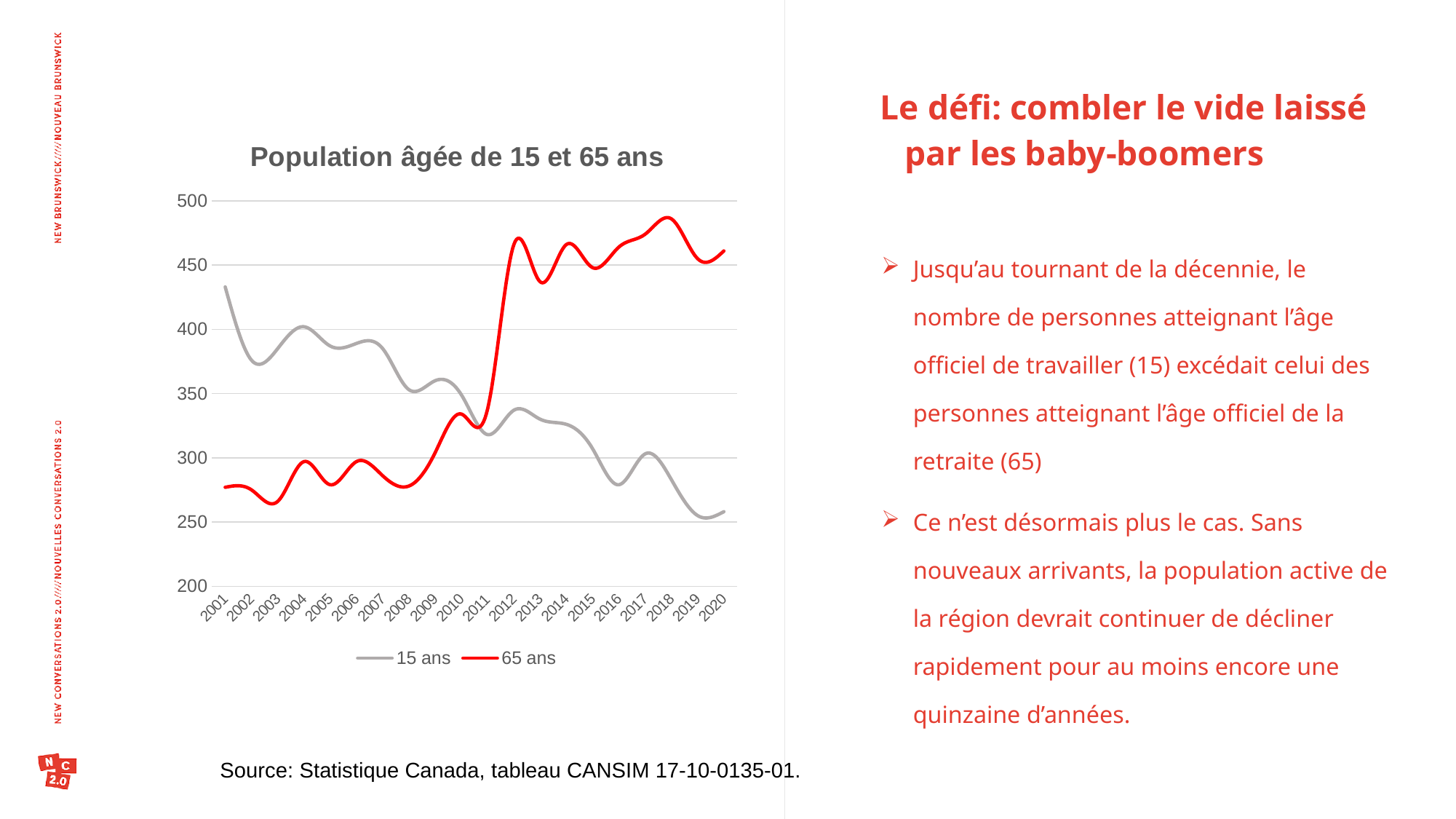
What kind of chart is shown on the slide? line chart Is the value for 15 ans in 2019 greater or less than 300? less How many years are shown on the x axis? 20 Does the 15 ans series generally rise or fall from 2001 to 2020? fall In which year does the 65 ans series reach its highest value? 2018 In which year does the 15 ans series reach its highest value? 2001 Is the value for 65 ans in 2018 greater or less than 450? greater Is the value for 65 ans in 2003 greater or less than 300? less In 2001, which series has the larger value, 15 ans or 65 ans? 15 ans In 2020, which series has the larger value, 15 ans or 65 ans? 65 ans How many series does the legend list? 2